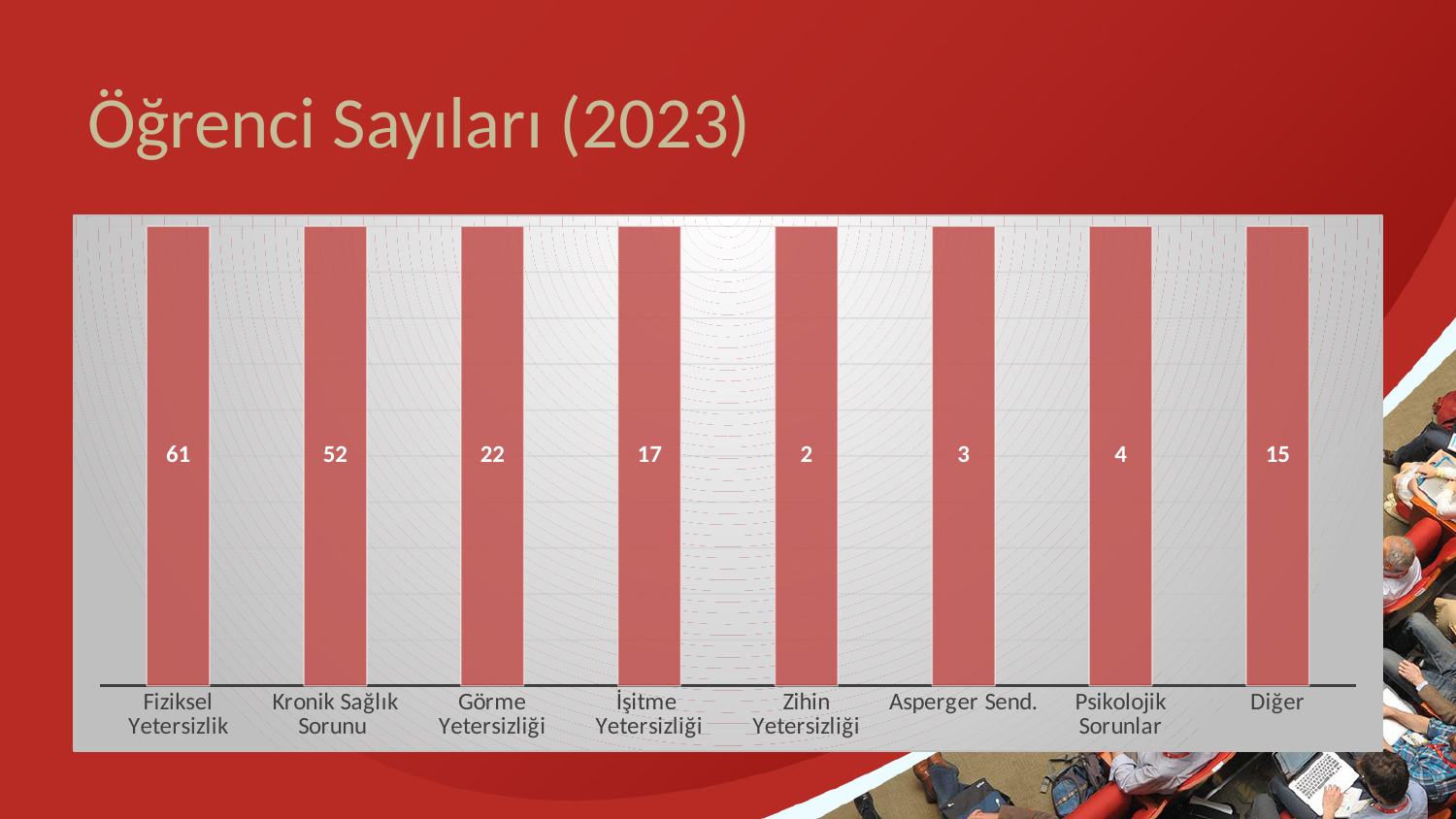
What is the value for Kronik Sağlık Sorunu? 52 What is the value for Diğer? 15 What is the value for Görme Yetersizliği? 22 What is the value for Fiziksel Yetersizlik? 61 Which category has the highest value? Fiziksel Yetersizlik Which is larger, the value for İşitme Yetersizliği or the value for Diğer? İşitme Yetersizliği What is the title of the slide? Öğrenci Sayıları (2023) What is the difference between the values for Fiziksel Yetersizlik and Kronik Sağlık Sorunu? 9 Which category has the lowest value? Zihin Yetersizliği How many categories are shown in the chart? 8 What kind of chart is shown on the slide? Bar chart What is the value for Zihin Yetersizliği? 2